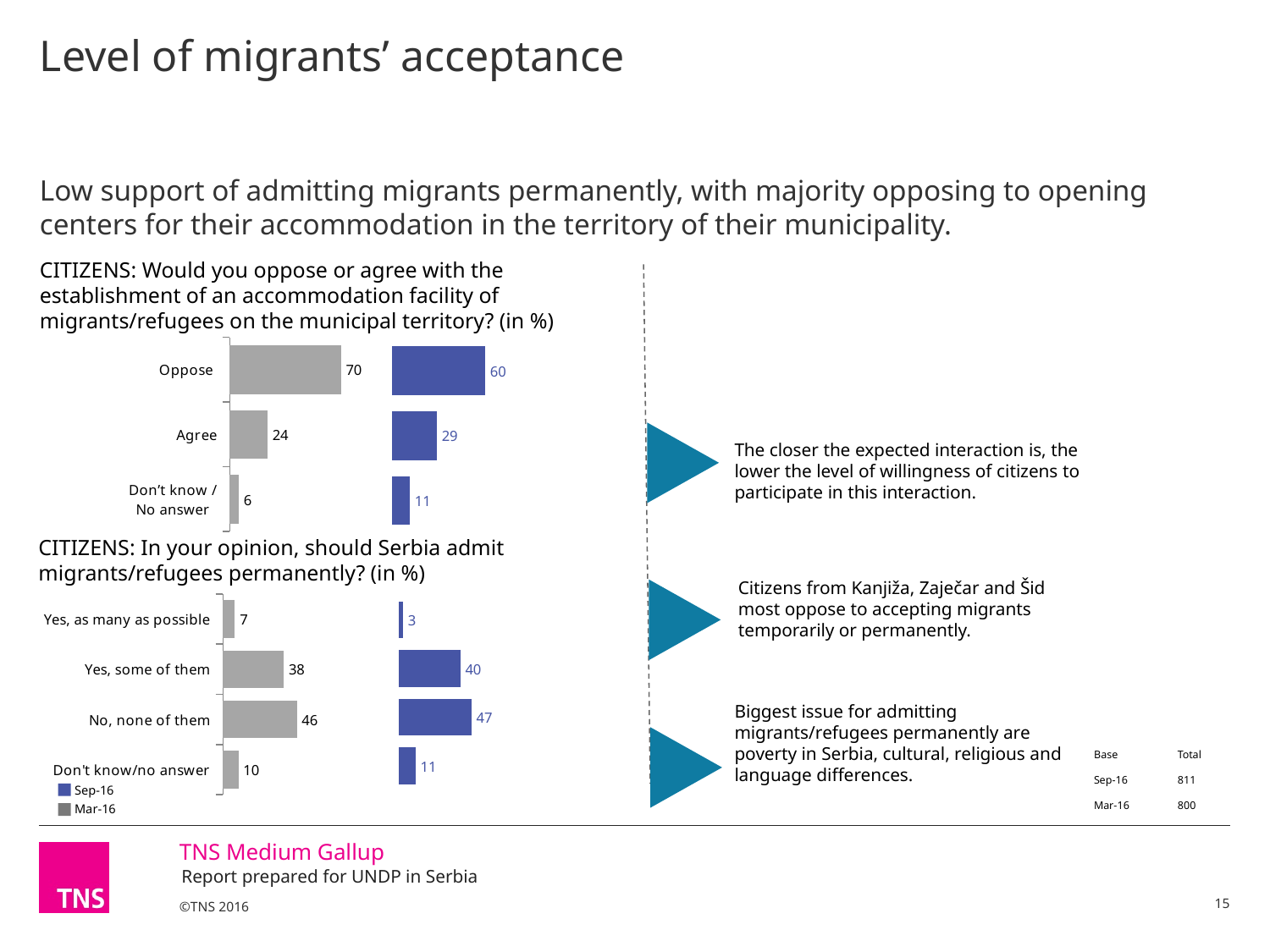
In the top chart about an accommodation facility on the municipal territory, how many categories are shown? 3 In the top chart about an accommodation facility on the municipal territory, what is the difference between the Mar-16 and Sep-16 values for Oppose? 10 In the top chart about an accommodation facility on the municipal territory, what is the Sep-16 value for Agree? 29 How many series does the legend list for the charts on the slide? 2 In the bottom chart about admitting migrants/refugees permanently, which category has the highest Sep-16 value? No, none of them In the bottom chart about admitting migrants/refugees permanently, what is the Mar-16 value for 'No, none of them'? 46 What type of chart is the bottom chart about admitting migrants/refugees permanently? Bar chart In the bottom chart about admitting migrants/refugees permanently, which is larger: the Mar-16 value for 'Yes, as many as possible' or the Sep-16 value for 'Yes, as many as possible'? Mar-16 In the bottom chart about admitting migrants/refugees permanently, what is the Sep-16 value for 'Yes, some of them'? 40 In the top chart about an accommodation facility on the municipal territory, which category has the lowest Mar-16 value? Don't know / No answer In the top chart about an accommodation facility on the municipal territory, what is the Mar-16 value for Oppose? 70 In the bottom chart about admitting migrants/refugees permanently, how many categories are shown? 4